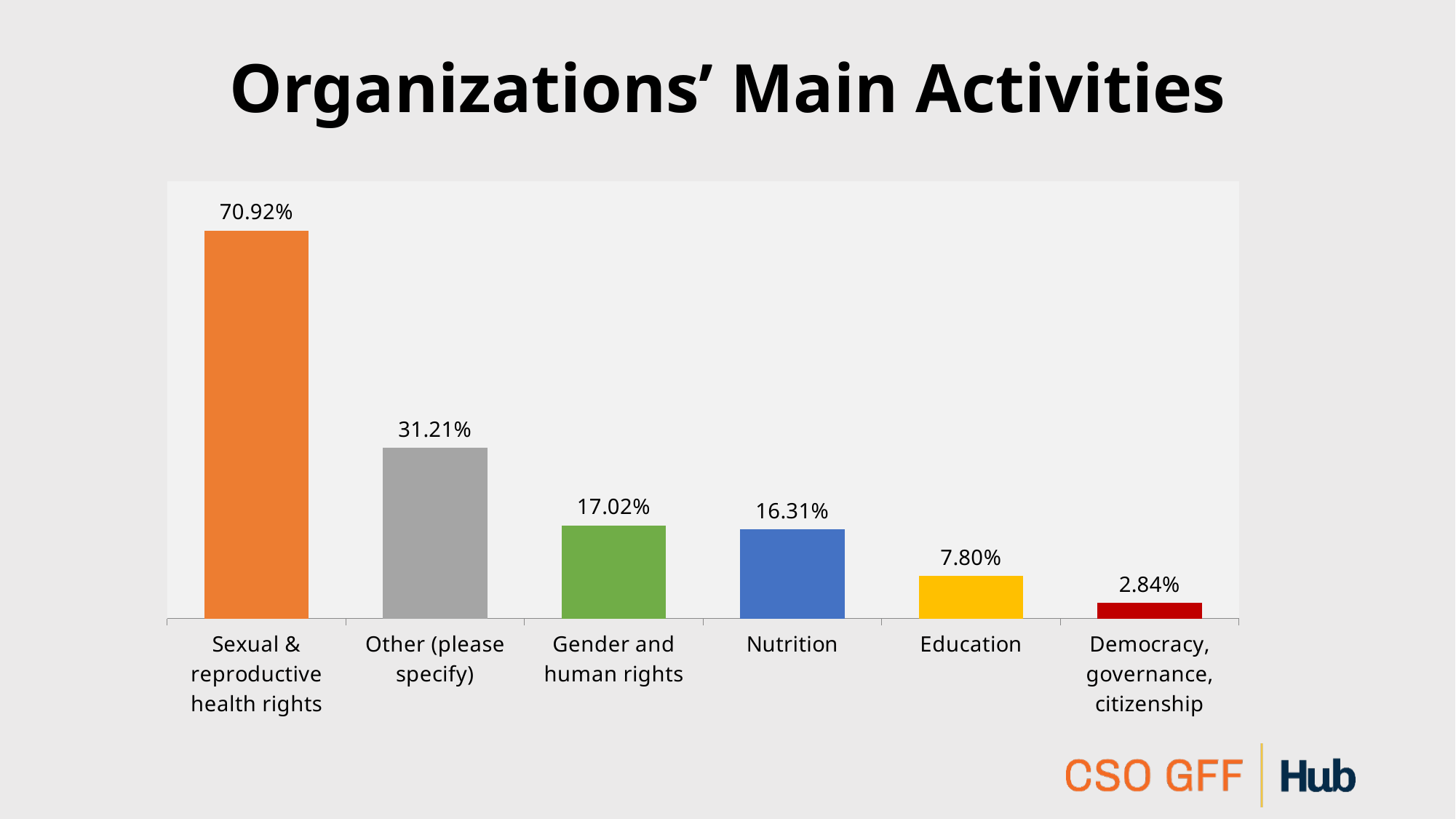
What is the value for Education? 7.80% What kind of chart is shown on the slide? Bar chart Which category has the highest value? Sexual & reproductive health rights What is the difference between the values for Gender and human rights and Nutrition? 0.71% Which category has the lowest value? Democracy, governance, citizenship What is the value for Sexual & reproductive health rights? 70.92% What is the title of the chart? Organizations' Main Activities How many categories are shown in the chart? 6 Do the values rise or fall from left to right across the categories? Fall What is the difference between the values for Sexual & reproductive health rights and Other (please specify)? 39.71% Which is larger, the value for Education or the value for Democracy, governance, citizenship? Education What is the value for Nutrition? 16.31%